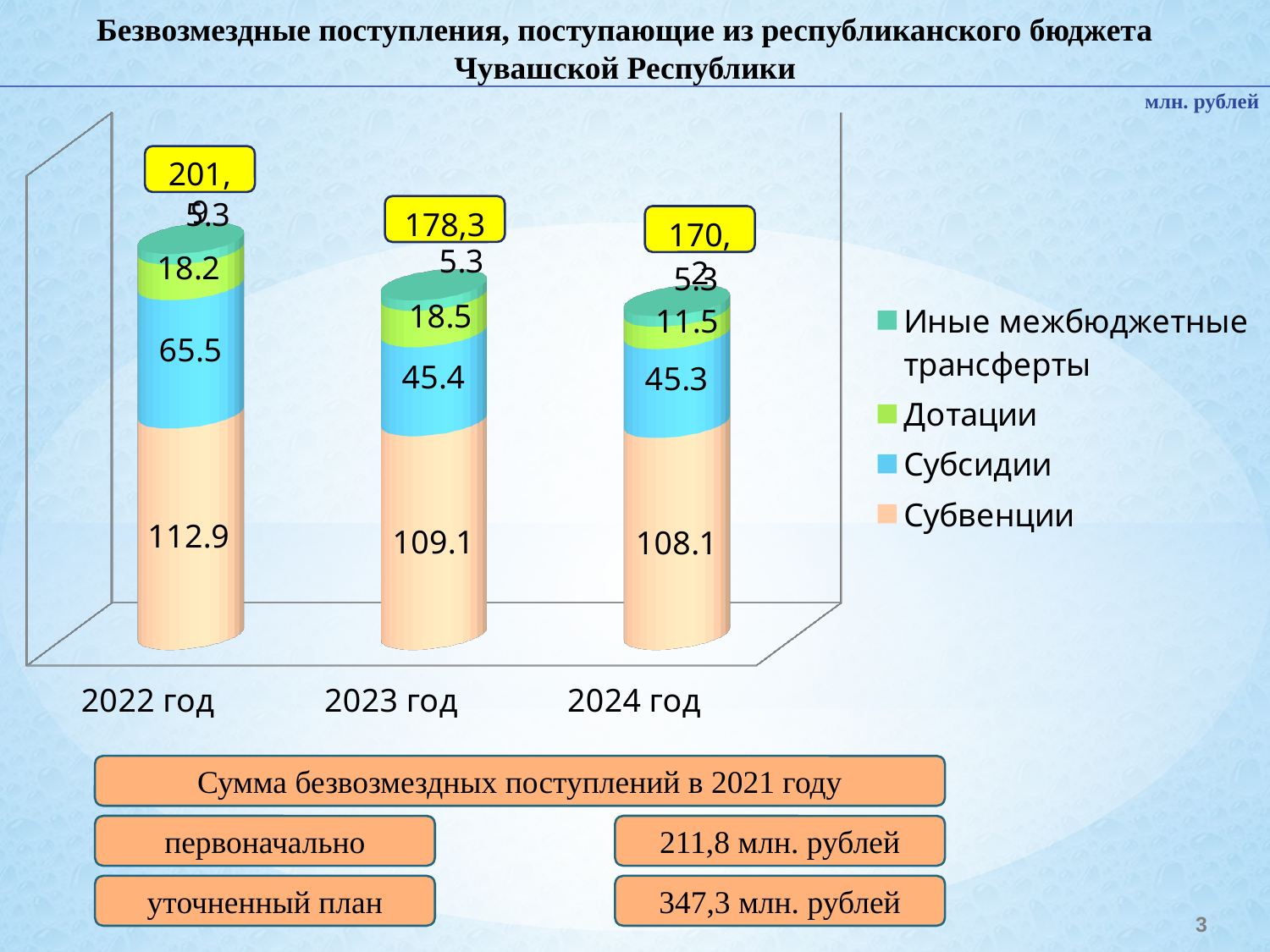
What is the difference between the Субсидии values for 2022 год and 2023 год? 20.1 In which year is the value of Дотации the lowest? 2024 год How many years (categories) are shown on the x axis of the chart? 3 What is the value of Субвенции for 2022 год? 112.9 In which year is the value of Субвенции the highest? 2022 год What is the total of the stacked bar for 2023 год? 178,3 What is the value of Дотации for 2024 год? 11.5 Do the Субвенции values rise or fall from 2022 год to 2024 год? Fall What kind of chart is shown on the slide? Stacked bar chart What is the value of Субсидии for 2023 год? 45.4 How many series does the chart legend list? 4 Which is larger for 2024 год: Субсидии or Дотации? Субсидии